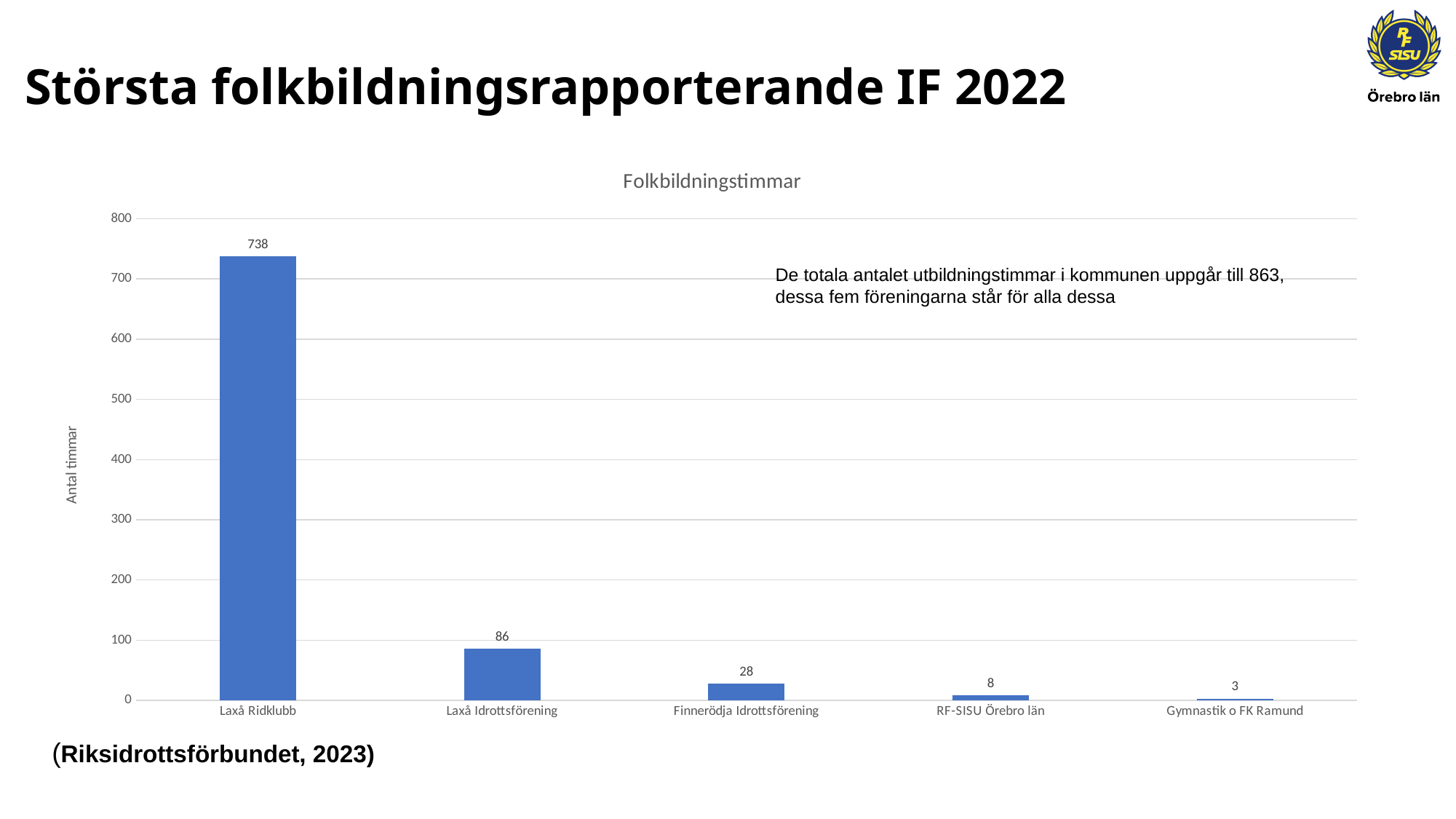
What kind of chart is shown on the slide? Bar chart How many categories are shown in the chart? 5 What is the value for Laxå Ridklubb? 738 What is the value for RF-SISU Örebro län? 8 Which category has the highest value? Laxå Ridklubb Which is larger, the value for Finnerödja Idrottsförening or RF-SISU Örebro län? Finnerödja Idrottsförening Which category has the lowest value? Gymnastik o FK Ramund What is the value for Gymnastik o FK Ramund? 3 What is the difference between the values for Laxå Ridklubb and Laxå Idrottsförening? 652 What is the value for Finnerödja Idrottsförening? 28 What is the title of the chart? Folkbildningstimmar What is the value for Laxå Idrottsförening? 86